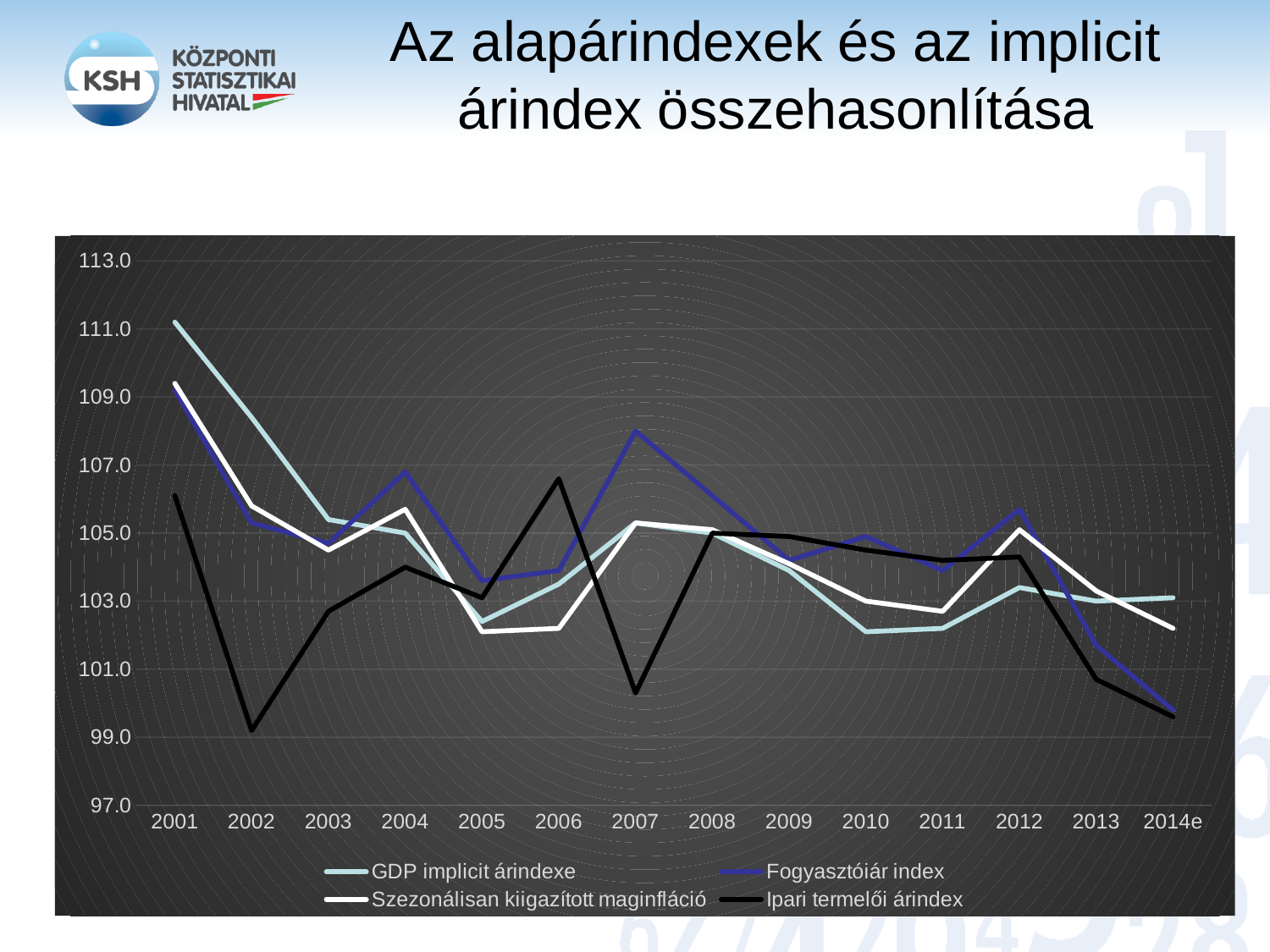
In which year is GDP implicit árindexe at its highest? 2001 Is the value of GDP implicit árindexe in 2001 greater or less than 109.0? greater Does GDP implicit árindexe rise or fall from 2001 to 2005? fall Is the value of Ipari termelői árindex in 2002 greater or less than 101.0? less How many years are shown along the x axis? 14 Which series is drawn with the black line? Ipari termelői árindex Is the value of Fogyasztóiár index in 2007 greater or less than 107.0? greater What kind of chart is shown on the slide? line chart In 2007, which is larger: Fogyasztóiár index or Ipari termelői árindex? Fogyasztóiár index In 2006, which is larger: Ipari termelői árindex or GDP implicit árindexe? Ipari termelői árindex How many series does the legend list? 4